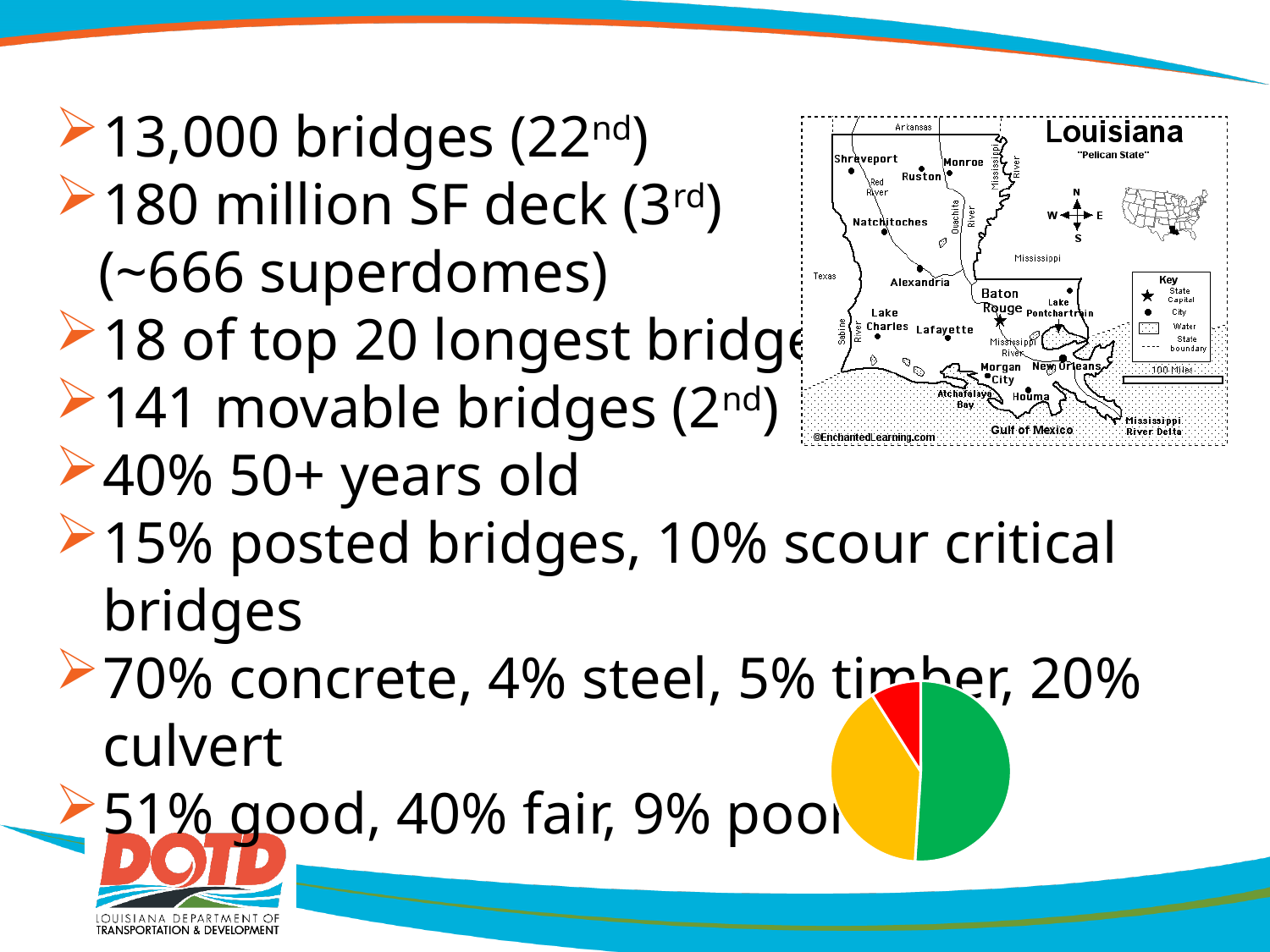
What colours are the slices of the pie chart in the lower right of the slide? Green, yellow and red Which slice of the pie chart in the lower right is the smallest? The red slice How many slices does the pie chart in the lower right of the slide have? 3 Does the pie chart in the lower right of the slide have a legend? No In the pie chart in the lower right, is the green slice or the red slice larger? The green slice Which slice of the pie chart in the lower right is the largest? The green slice In the pie chart in the lower right, is the yellow slice or the red slice larger? The yellow slice What kind of chart is shown in the lower right of the slide? Pie chart